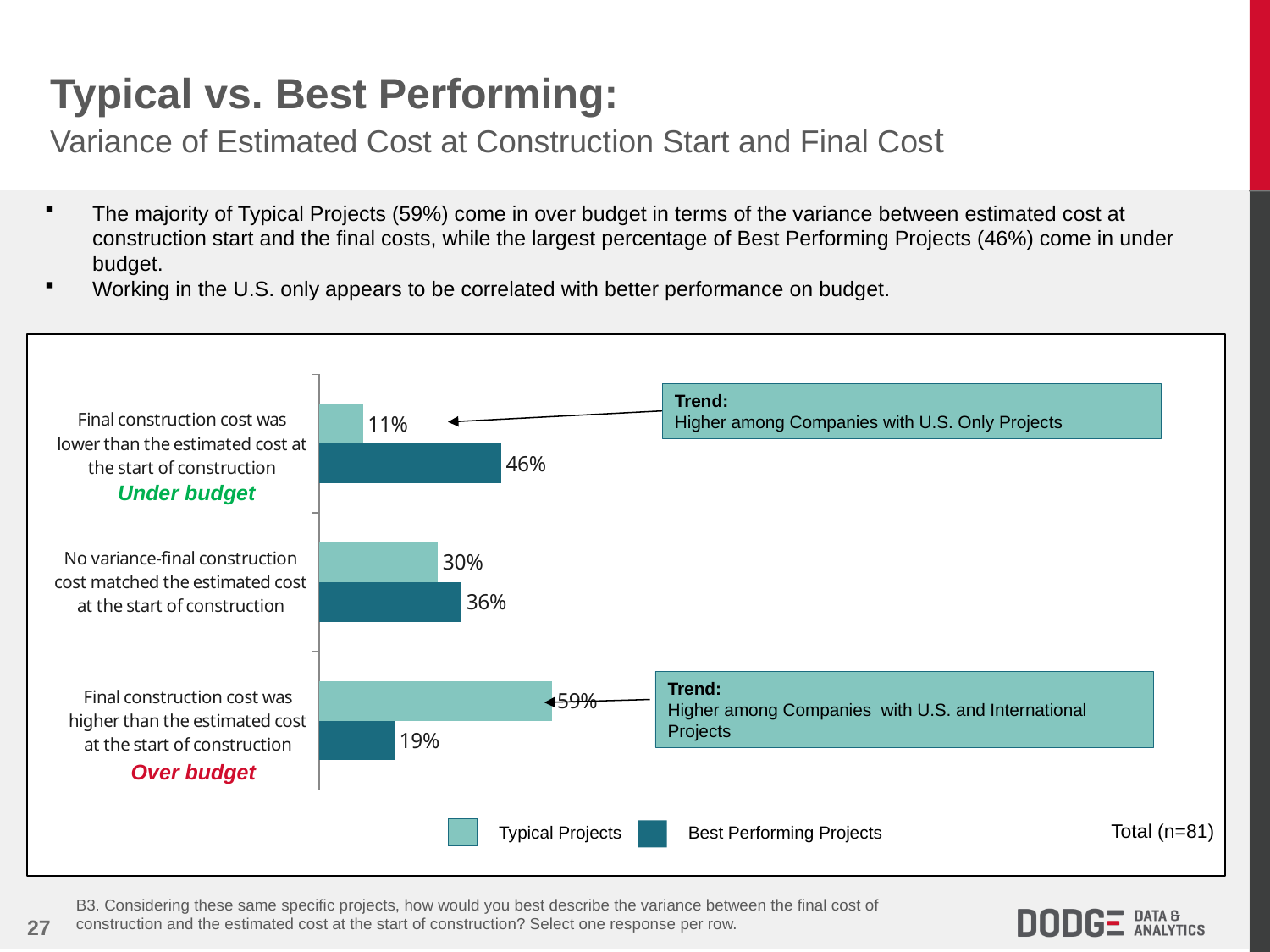
Which category has the highest value for Typical Projects? Over budget (final construction cost was higher than the estimated cost) What percentage of Typical Projects had no variance between final and estimated cost? 30% How many series does the legend list? 2 For the no variance category, which series has the larger value, Typical Projects or Best Performing Projects? Best Performing Projects What percentage of Best Performing Projects came in under budget? 46% What is the difference between the Typical Projects and Best Performing Projects values for the over budget category? 40 percentage points What is the difference between Best Performing Projects and Typical Projects for the under budget category? 35 percentage points What percentage of Best Performing Projects came in over budget? 19% Which category has the lowest value for Best Performing Projects? Over budget (final construction cost was higher than the estimated cost) What kind of chart is shown on the slide? Bar chart What percentage of Typical Projects had a final construction cost lower than the estimated cost at the start of construction (under budget)? 11% How many categories are shown on the chart? 3